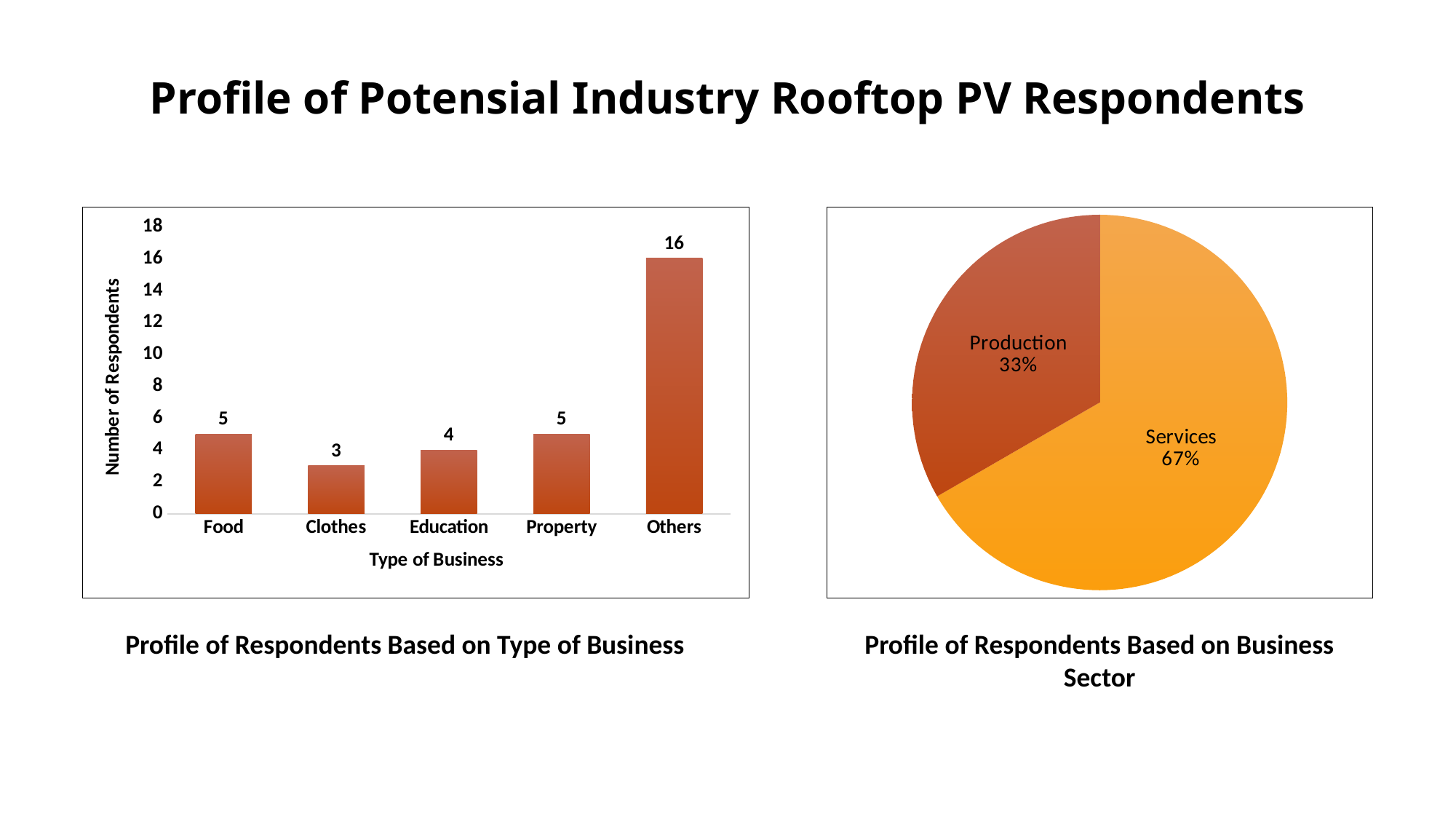
In the 'Profile of Respondents Based on Type of Business' chart, which type of business has the highest number of respondents? Others What kind of chart is 'Profile of Respondents Based on Business Sector'? Pie chart In the 'Profile of Respondents Based on Type of Business' chart, how many respondents are in the Clothes category? 3 In the 'Profile of Respondents Based on Business Sector' pie chart, what share of respondents is in the Production sector? 33% What kind of chart is 'Profile of Respondents Based on Type of Business'? Bar chart In the 'Profile of Respondents Based on Type of Business' chart, what is the label of the y axis? Number of Respondents In the 'Profile of Respondents Based on Type of Business' chart, which type of business has the lowest number of respondents? Clothes In the 'Profile of Respondents Based on Type of Business' chart, how many respondents are in the Education category? 4 In the 'Profile of Respondents Based on Business Sector' pie chart, which sector has the larger share? Services In the 'Profile of Respondents Based on Type of Business' chart, what is the difference between the number of respondents for Others and for Food? 11 In the 'Profile of Respondents Based on Type of Business' chart, which has more respondents, Property or Education? Property In the 'Profile of Respondents Based on Type of Business' chart, how many types of business are shown on the x axis? 5